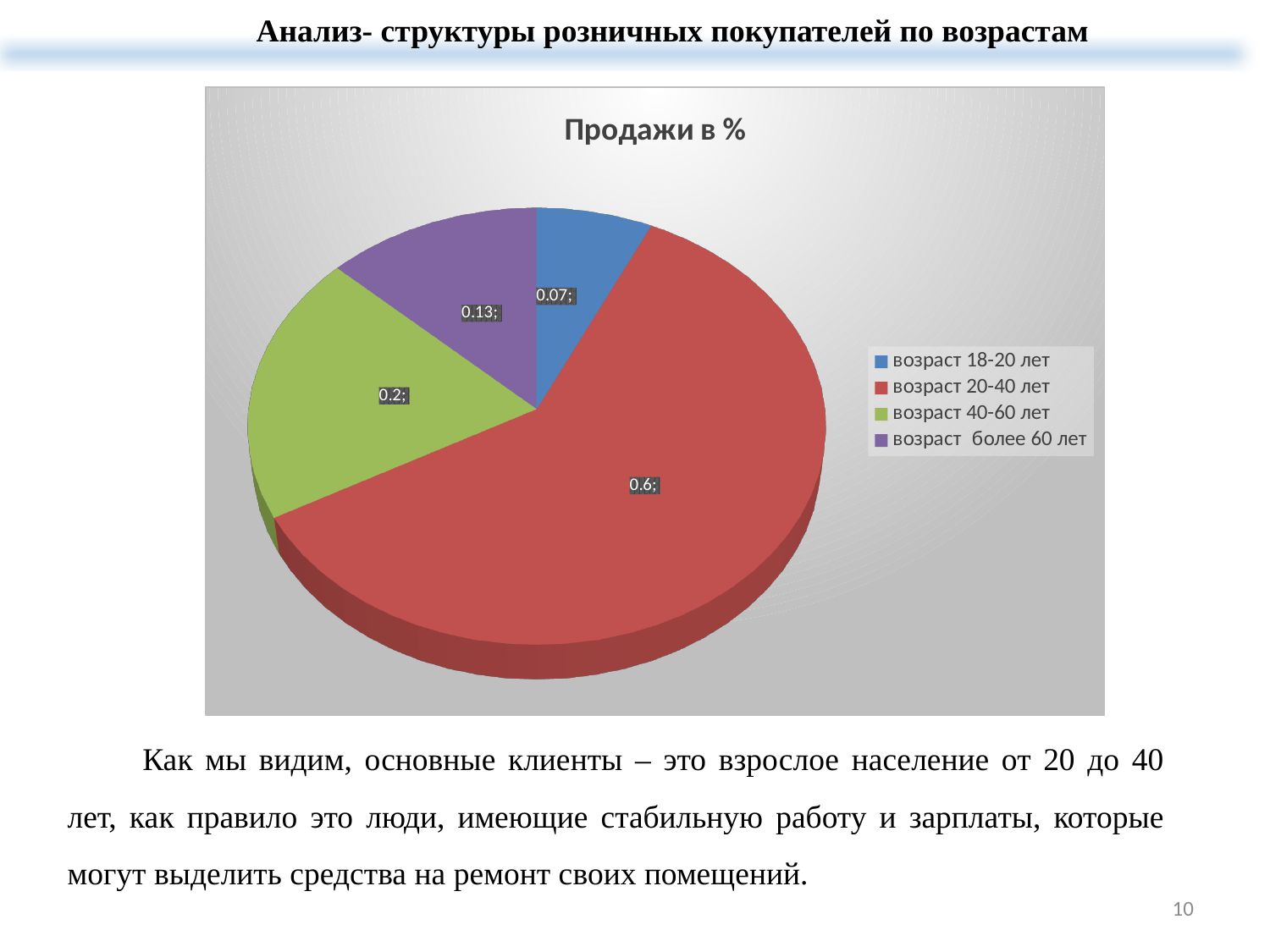
Which age group has the smallest slice? возраст 18-20 лет Which age group has the largest slice? возраст 20-40 лет Which is larger, the value for возраст более 60 лет or the value for возраст 18-20 лет? возраст более 60 лет What is the chart's title? Продажи в % What is the value shown for возраст 40-60 лет? 0.2 What type of chart is shown on the slide? Pie chart What is the value shown for возраст 20-40 лет? 0.6 How many slices does the pie chart have? 4 What is the value shown for возраст более 60 лет? 0.13 How many entries does the legend list? 4 What is the value shown for возраст 18-20 лет? 0.07 What is the difference between the values for возраст 20-40 лет and возраст 40-60 лет? 0.4